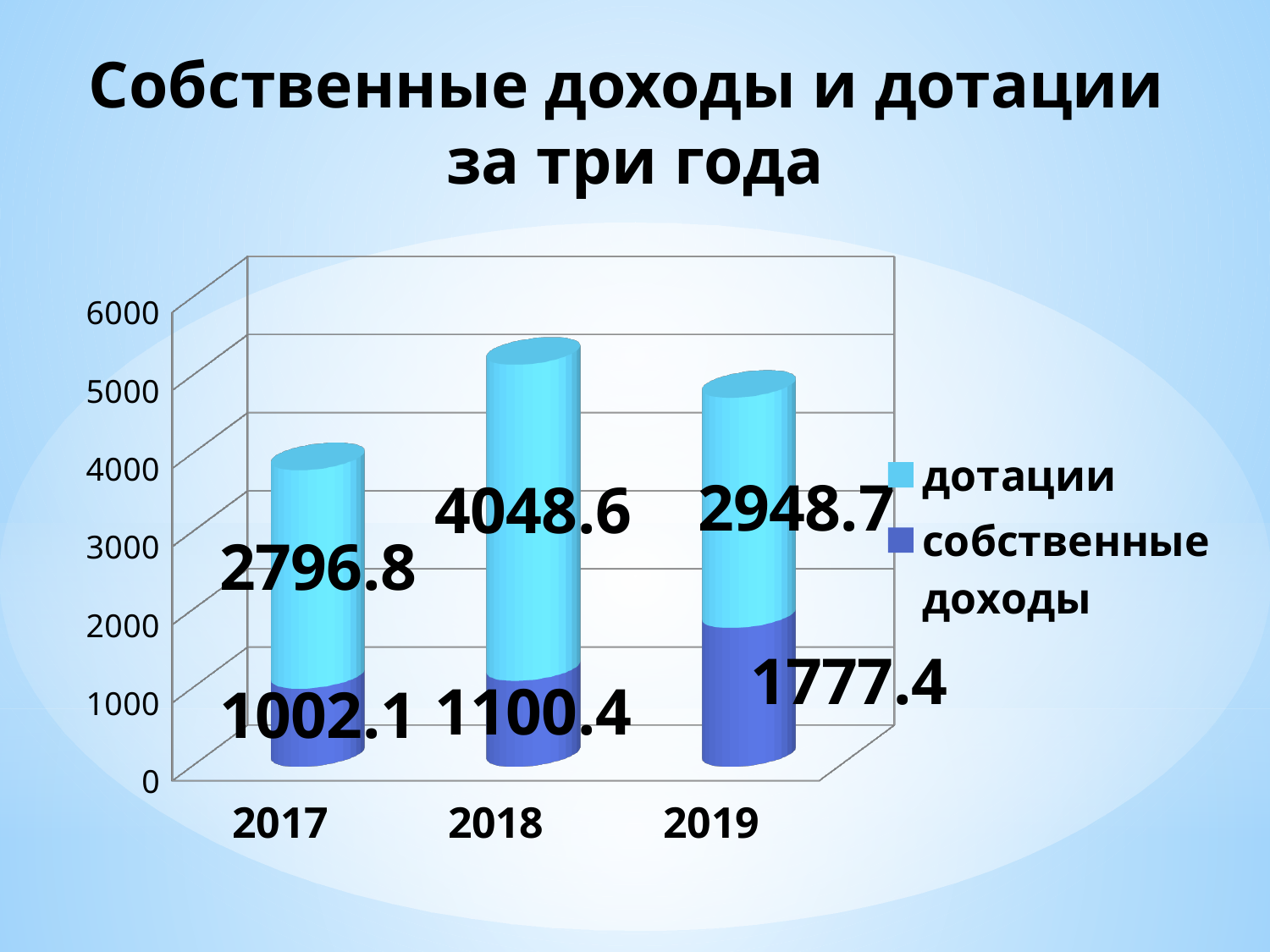
Which year has the lowest value for собственные доходы? 2017 Which year has the highest value for дотации? 2018 What is the difference between дотации in 2018 and дотации in 2017? 1251.8 What is the total of the stacked bar for 2019? 4726.1 What kind of chart is shown on the slide? Stacked bar chart How many years are shown on the x axis? 3 Which is larger: собственные доходы in 2019 or собственные доходы in 2018? собственные доходы in 2019 Does the value of собственные доходы rise or fall from 2017 to 2019? Rise What is the value of собственные доходы for 2017? 1002.1 How many series does the legend list? 2 What is the value of собственные доходы for 2019? 1777.4 What is the value of дотации for 2018? 4048.6